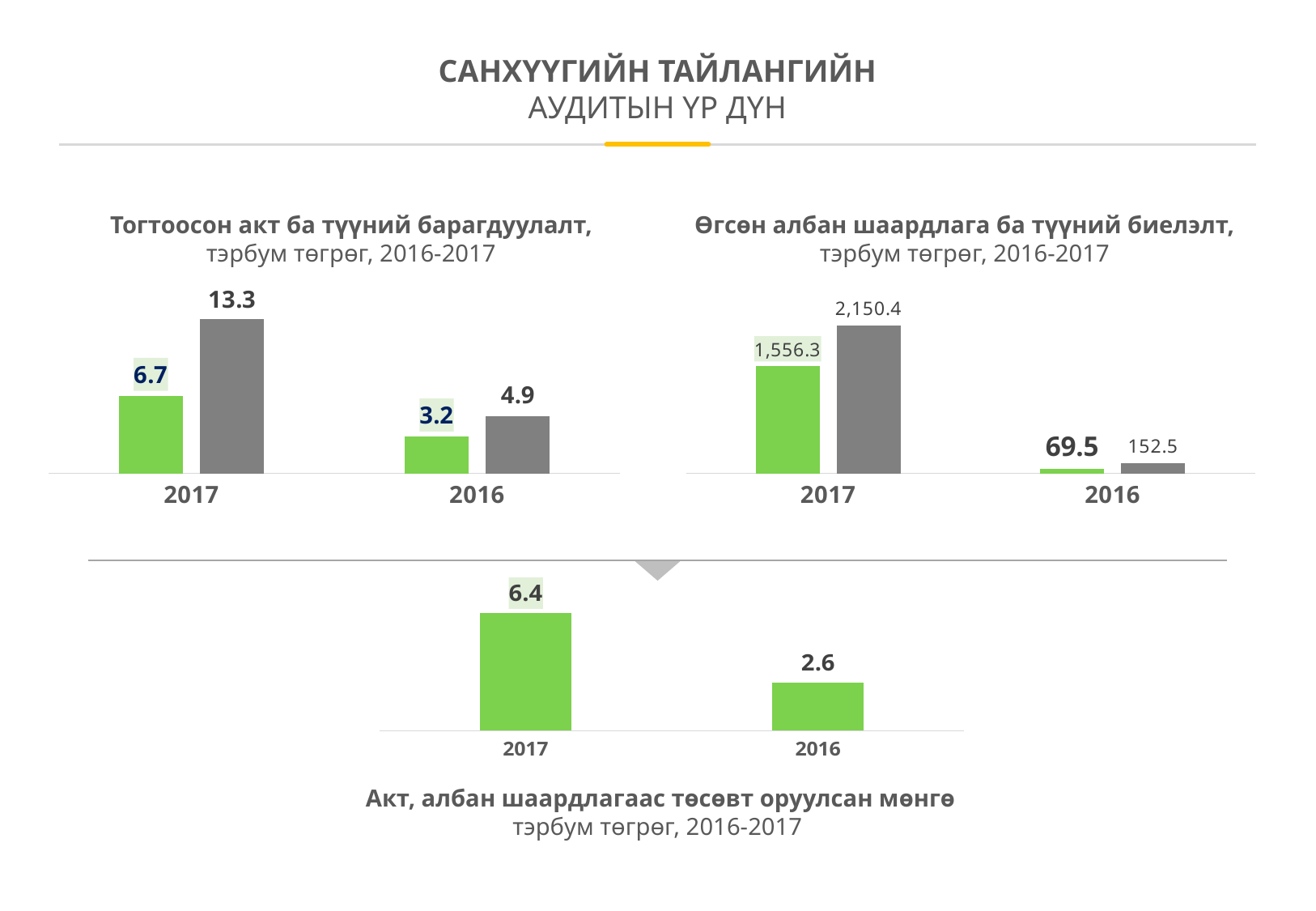
In the bottom chart (Акт, албан шаардлагаас төсөвт оруулсан мөнгө), what is the value for 2017? 6.4 In the bottom chart (Акт, албан шаардлагаас төсөвт оруулсан мөнгө), which year has the lowest value? 2016 In the top-right chart (Өгсөн албан шаардлага ба түүний биелэлт), which year has the higher grey bar? 2017 In the bottom chart (Акт, албан шаардлагаас төсөвт оруулсан мөнгө), what is the difference between the 2017 and 2016 values? 3.8 In the top-left chart (Тогтоосон акт ба түүний барагдуулалт), what is the value of the grey bar for 2017? 13.3 In the top-right chart (Өгсөн албан шаардлага ба түүний биелэлт), what is the value of the grey bar for 2016? 152.5 How many bars are shown in the bottom chart (Акт, албан шаардлагаас төсөвт оруулсан мөнгө)? 2 What type of chart is the top-left chart (Тогтоосон акт ба түүний барагдуулалт)? Bar chart In the top-right chart (Өгсөн албан шаардлага ба түүний биелэлт), what is the difference between the grey bar and the green bar for 2016? 83.0 In the top-left chart (Тогтоосон акт ба түүний барагдуулалт), what is the value of the green bar for 2016? 3.2 In the top-left chart (Тогтоосон акт ба түүний барагдуулалт), what is the difference between the grey bar and the green bar for 2017? 6.6 In the top-right chart (Өгсөн албан шаардлага ба түүний биелэлт), what is the value of the green bar for 2017? 1,556.3